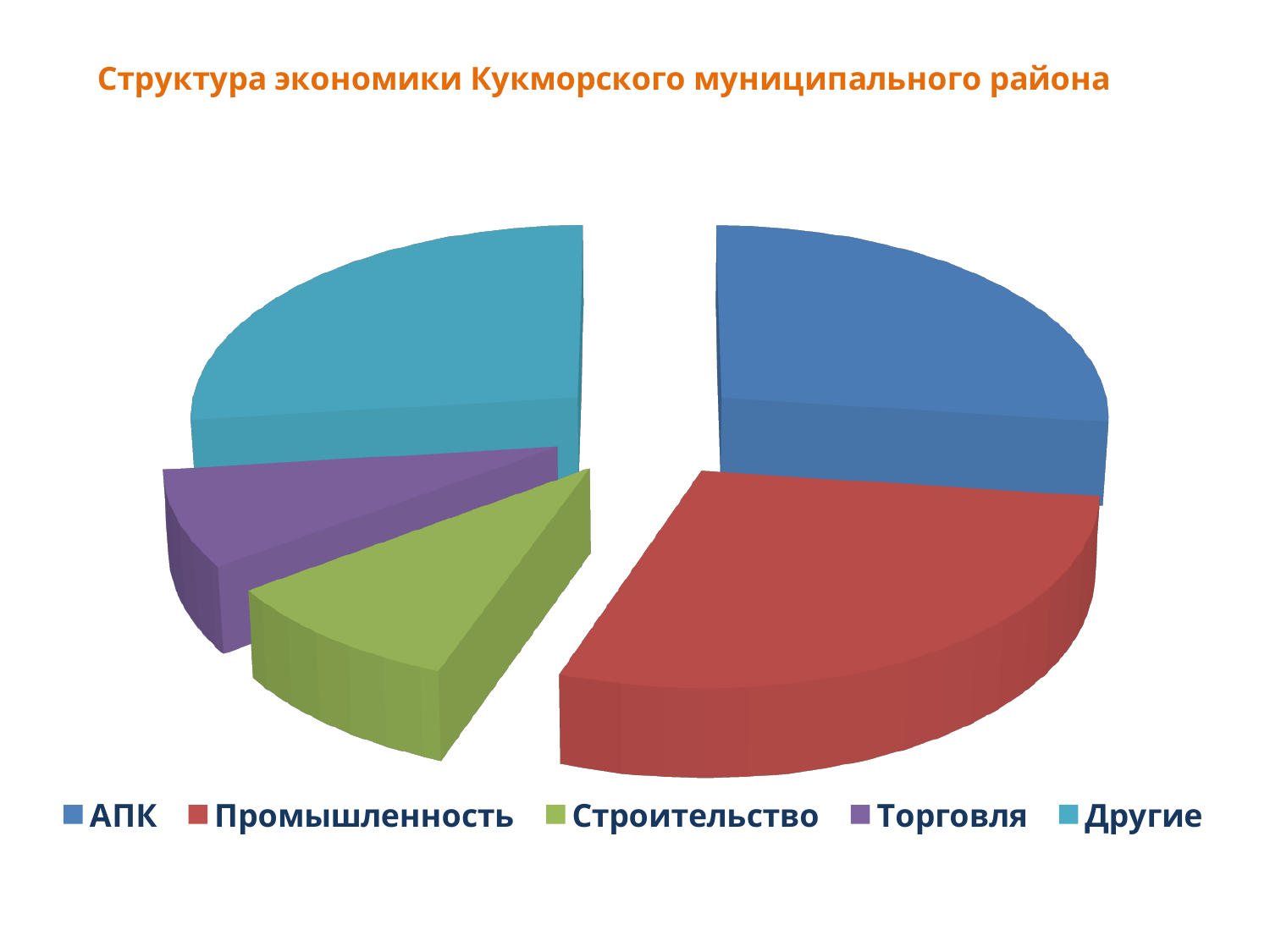
Which category is shown in red in the pie chart? Промышленность Which slice is larger, Промышленность or Торговля? Промышленность How many entries does the legend list? 5 What kind of chart is shown on the slide? Pie chart How many categories does the pie chart show? 5 Which slice is larger, Другие or Торговля? Другие Which slice is larger, АПК or Строительство? АПК What is the title of the chart? Структура экономики Кукморского муниципального района Which category has the smallest slice of the pie? Торговля Which category has the largest slice of the pie? Промышленность